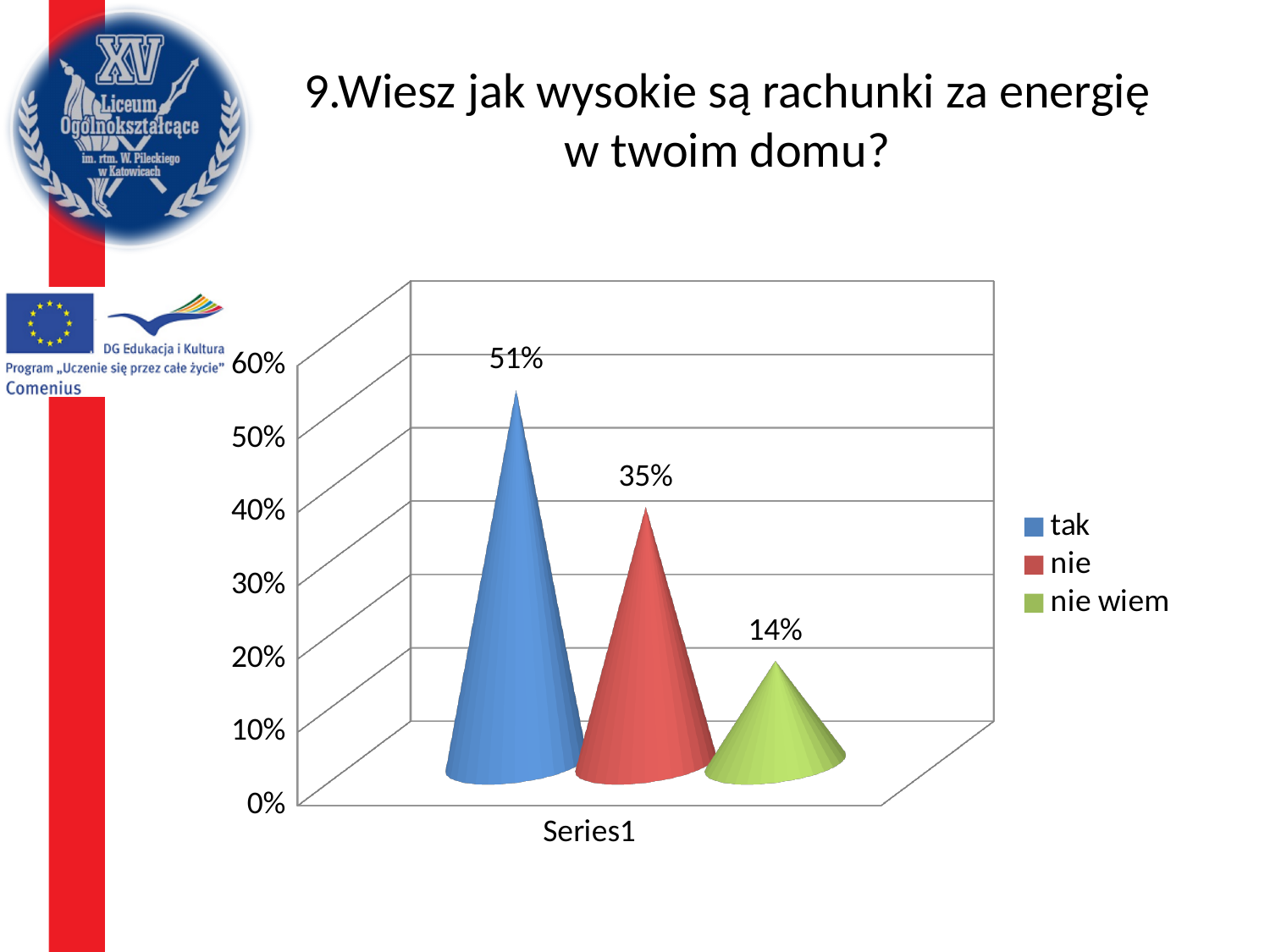
Is the value for "tak" greater or less than 50%? greater What is the value for "nie"? 35% What kind of chart is shown on the slide? bar chart What is the difference between the values for "nie" and "nie wiem"? 21% Which is larger, the value for "nie" or the value for "nie wiem"? nie What is the difference between the values for "tak" and "nie"? 16% Which answer has the lowest value? nie wiem How many entries does the legend list? 3 Which answer has the highest value? tak What is the value for "nie wiem"? 14% What colour represents "nie wiem" in the legend? green What is the value for "tak"? 51%